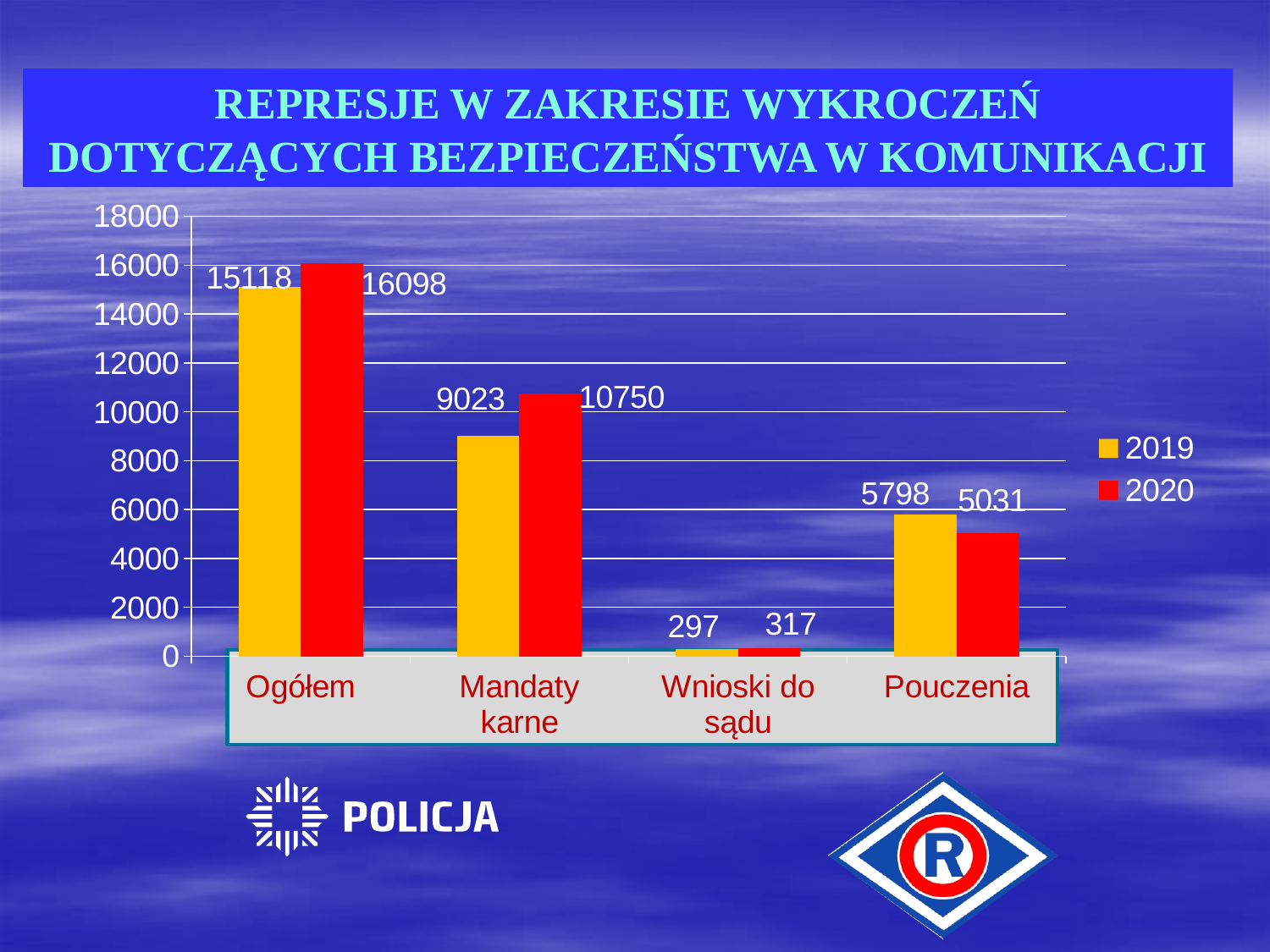
Which category has the highest 2019 value? Ogółem What is the difference between the 2020 and 2019 values for Ogółem? 980 What is the 2019 value for Ogółem? 15118 For Mandaty karne, which year has the larger value, 2019 or 2020? 2020 What is the 2020 value for Pouczenia? 5031 Which category has the lowest 2020 value? Wnioski do sądu What is the 2020 value for Mandaty karne? 10750 How many series does the legend list? 2 How many categories are shown on the x axis? 4 What kind of chart is shown on the slide? Bar chart What is the difference between the 2019 and 2020 values for Pouczenia? 767 What is the 2019 value for Wnioski do sądu? 297